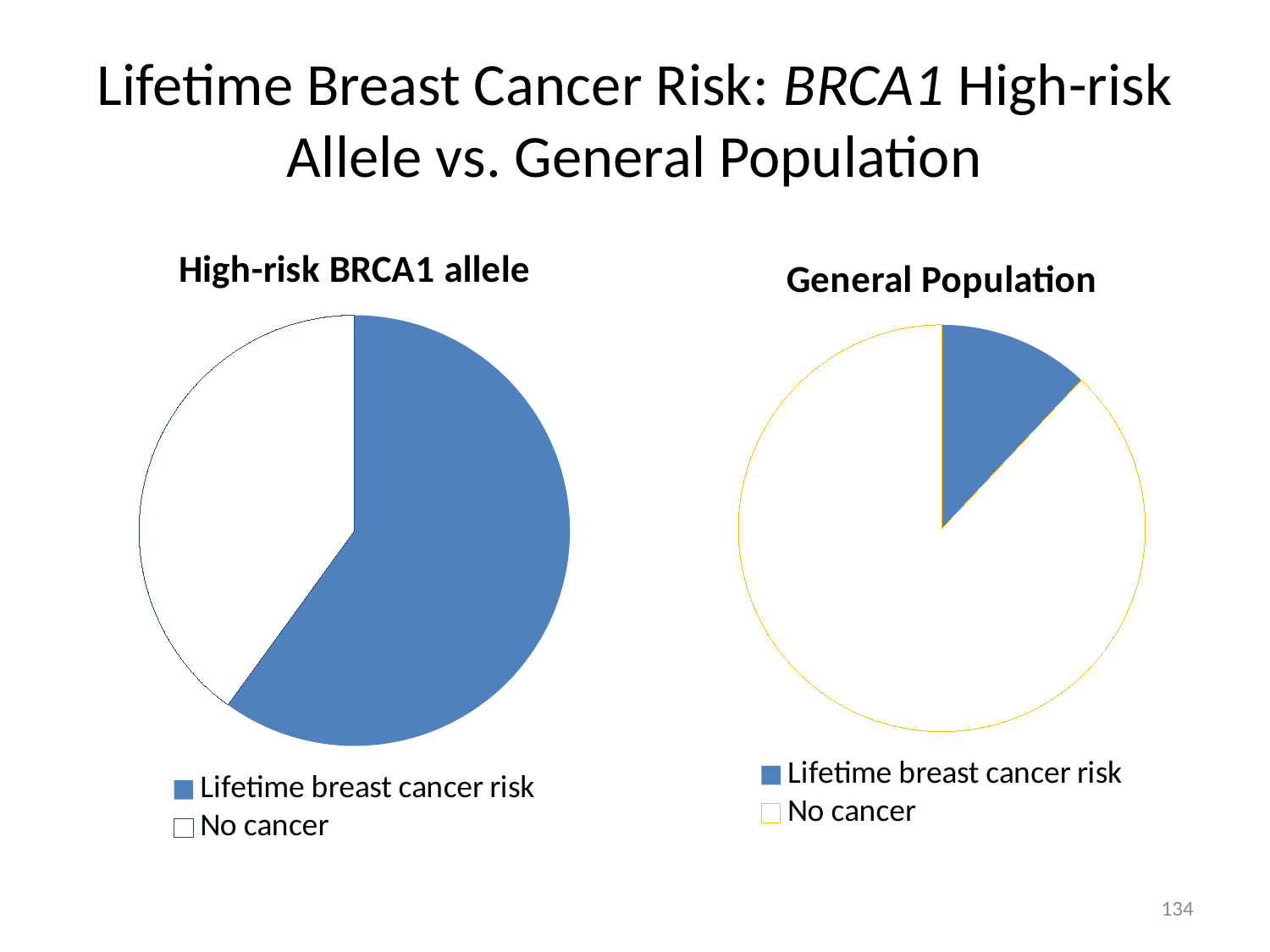
In the "General Population" chart, which slice is the smallest? Lifetime breast cancer risk What colour is the "Lifetime breast cancer risk" slice in the "High-risk BRCA1 allele" chart? Blue In the "General Population" chart, which slice is larger? No cancer What kind of chart is the "High-risk BRCA1 allele" chart? Pie chart How many slices does the "High-risk BRCA1 allele" pie chart have? 2 What kind of chart is the "General Population" chart? Pie chart In the "High-risk BRCA1 allele" chart, which slice is larger? Lifetime breast cancer risk What is the title of the pie chart on the right side of the slide? General Population Is the "Lifetime breast cancer risk" slice larger in the "High-risk BRCA1 allele" chart or in the "General Population" chart? High-risk BRCA1 allele In the "High-risk BRCA1 allele" chart, which slice is the smallest? No cancer How many slices does the "General Population" pie chart have? 2 How many entries does the legend of the "General Population" chart list? 2